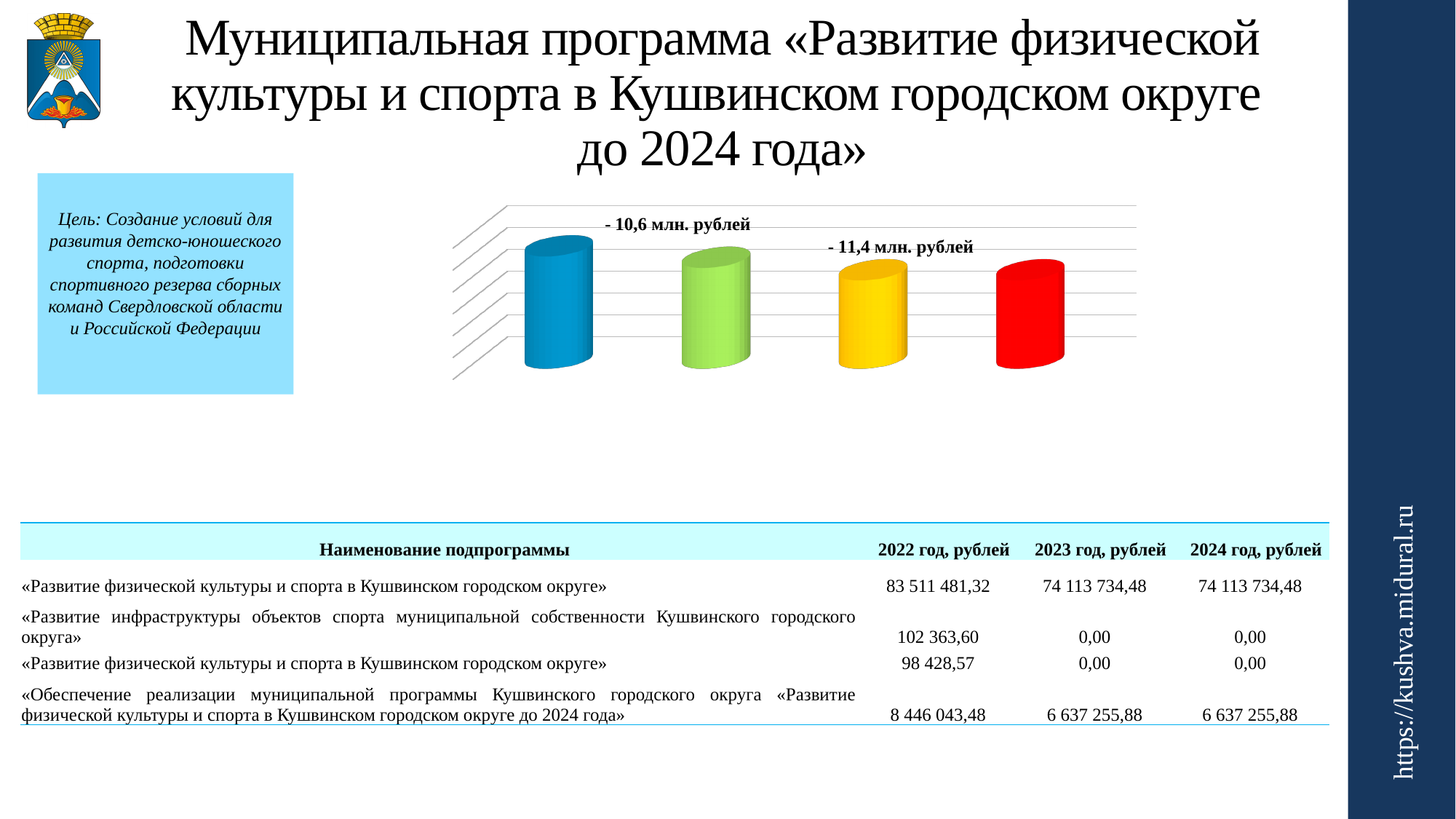
Which is taller in the chart, the blue bar or the green bar? the blue bar What kind of chart is shown on the slide? bar chart What colour is the leftmost bar in the chart? blue Which is taller in the chart, the green bar or the yellow bar? the green bar Do the bar heights generally rise or fall from left to right across the chart? fall What two values are printed as text labels above the bars in the chart? - 10,6 млн. рублей and - 11,4 млн. рублей Which is taller in the chart, the blue bar or the red bar? the blue bar Which bar in the chart is the tallest? the blue bar How many bars does the chart contain? 4